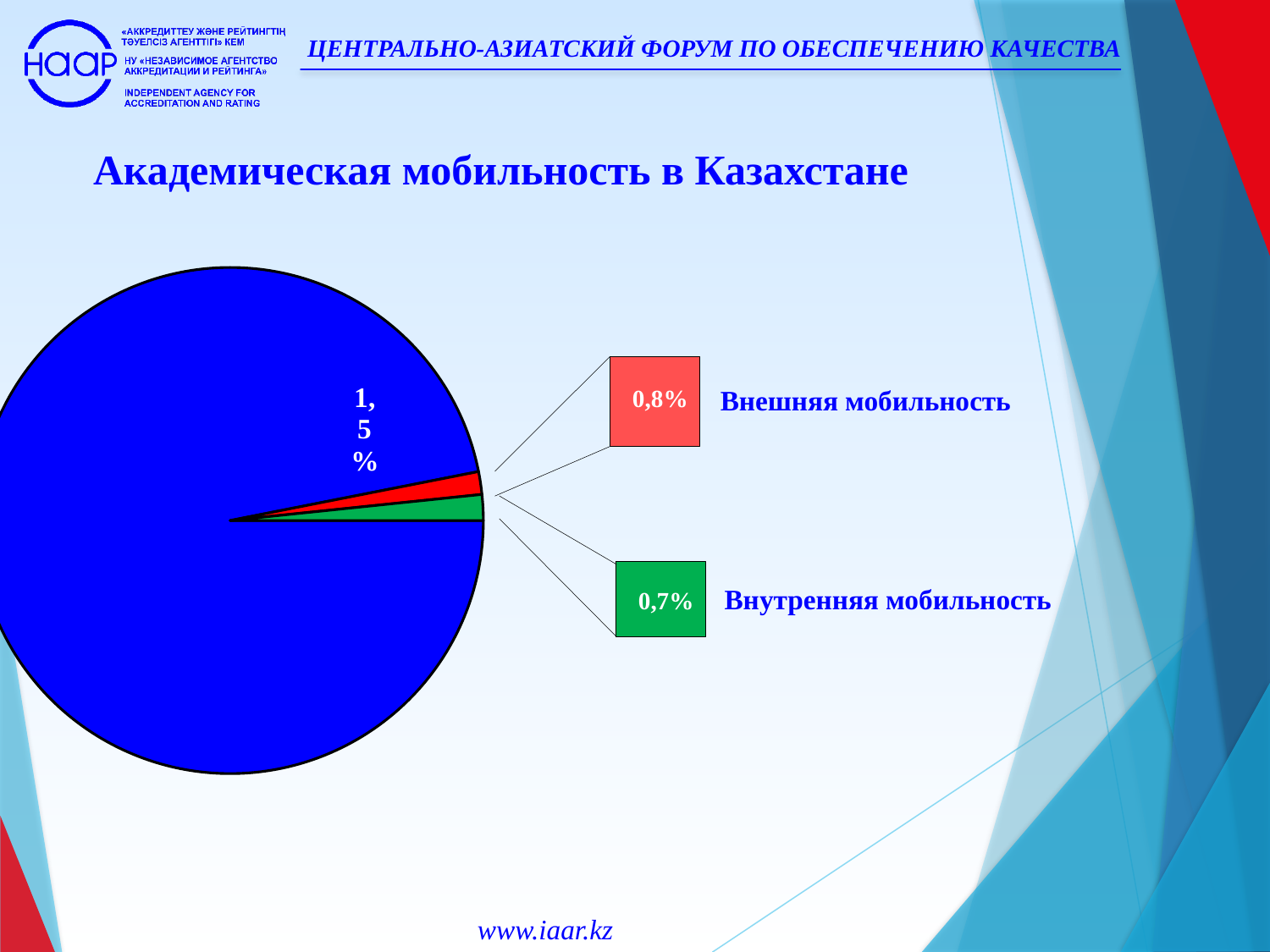
What kind of chart is shown on the slide? pie chart What is the title of the slide above the chart? Академическая мобильность в Казахстане What is the difference between the values for Внешняя мобильность and Внутренняя мобильность? 0,1% How many slices does the pie chart have? 3 What percentage is shown for Внутренняя мобильность? 0,7% What value is printed on the large blue slice of the pie? 1,5% What percentage is shown for Внешняя мобильность? 0,8% Which slice of the pie is the largest by area? the blue slice Which is larger, Внешняя мобильность or Внутренняя мобильность? Внешняя мобильность Which of the two labelled mobility types, Внешняя or Внутренняя, has the smaller value? Внутренняя мобильность What colour is the slice for Внешняя мобильность? red